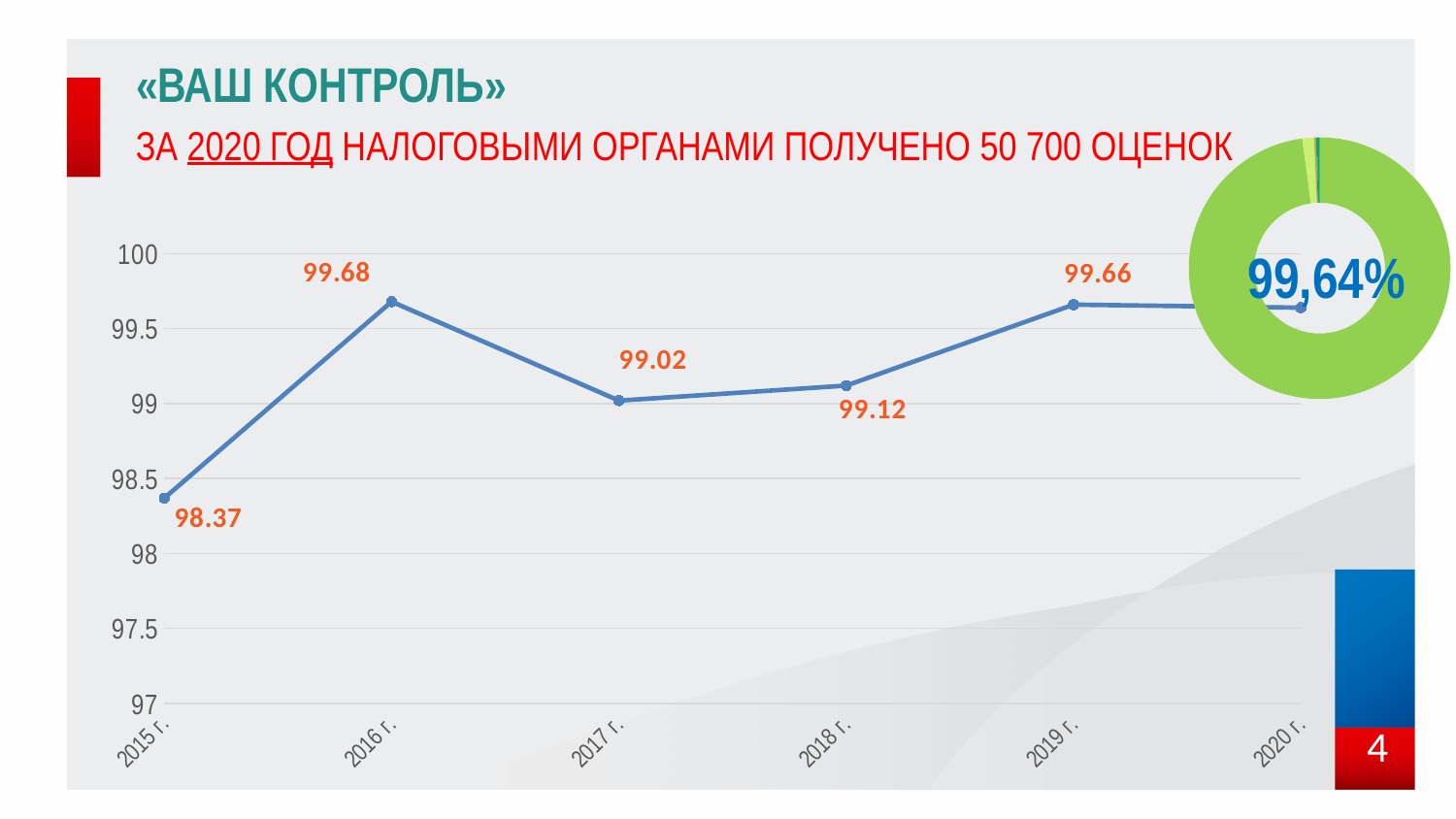
In the line chart, what is the value for 2015 г.? 98.37 In the line chart, which year has the highest labelled value? 2016 г. In the line chart, what is the value for 2016 г.? 99.68 In the line chart, which is larger: the value for 2017 г. or the value for 2018 г.? 2018 г. In the line chart, which year has the lowest value? 2015 г. How many years are plotted on the x axis of the line chart? 6 In the line chart, does the value rise or fall from 2016 г. to 2017 г.? fall In the line chart, what is the difference between the values for 2016 г. and 2015 г.? 1.31 What kind of chart is the large chart on the left of the slide? line chart In the line chart, what is the value for 2018 г.? 99.12 In the line chart, what is the value for 2019 г.? 99.66 In the line chart, is the value for 2015 г. greater or less than 98.5? less